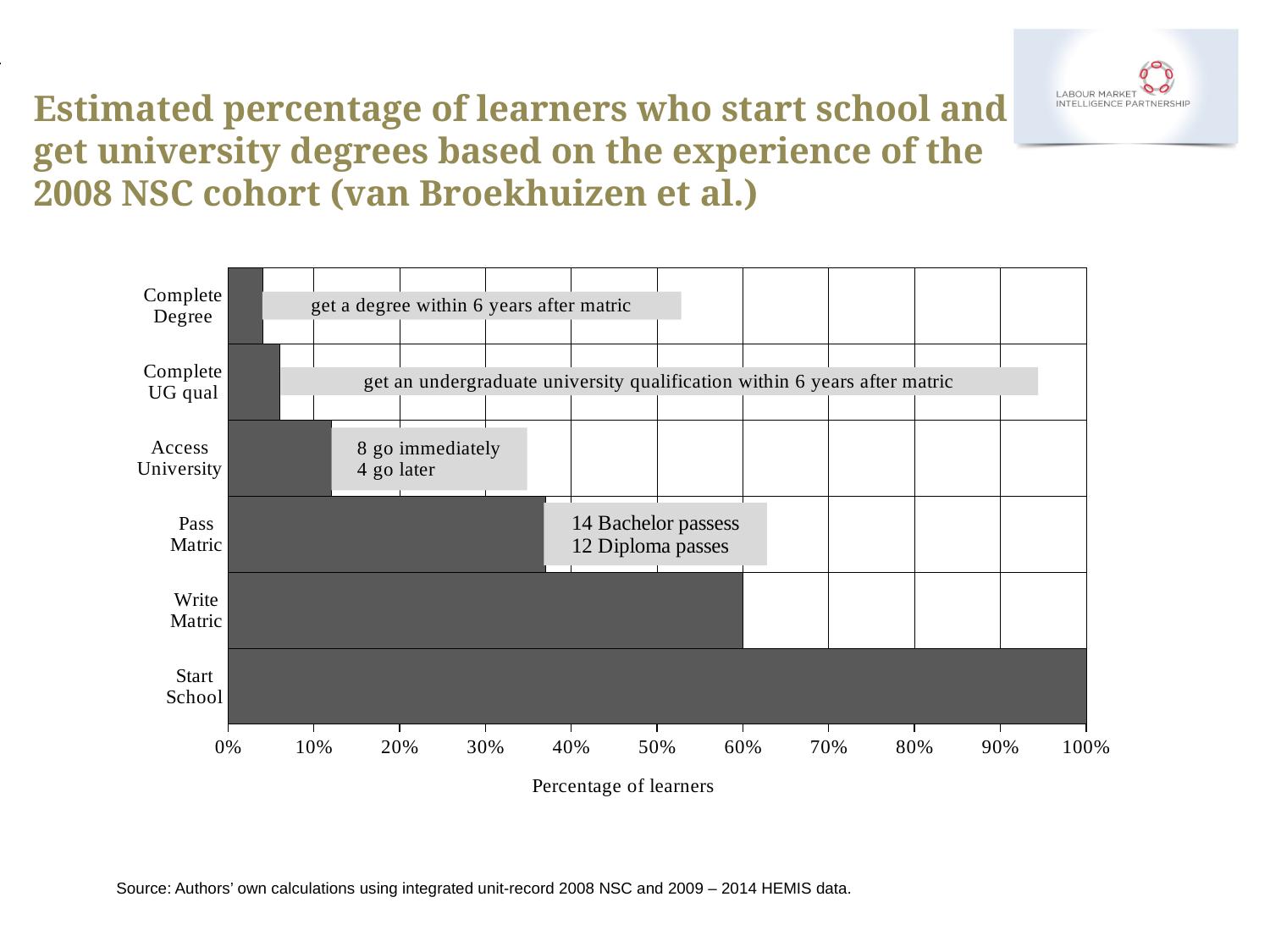
What is the percentage of learners for Write Matric? 60% What is the percentage of learners for Start School? 100% Which category has the lowest percentage of learners? Complete Degree Is the value for Pass Matric greater or less than 40%? less What text is shown in the label next to the Access University bar? 8 go immediately 4 go later What is the title of the x axis? Percentage of learners What is the difference between the percentage of learners for Start School and Write Matric? 40% Which category has the highest percentage of learners? Start School What kind of chart is shown on the slide? bar chart How many categories are shown on the chart? 6 Which is larger, the value for Write Matric or the value for Pass Matric? Write Matric Is the value for Access University greater or less than 20%? less